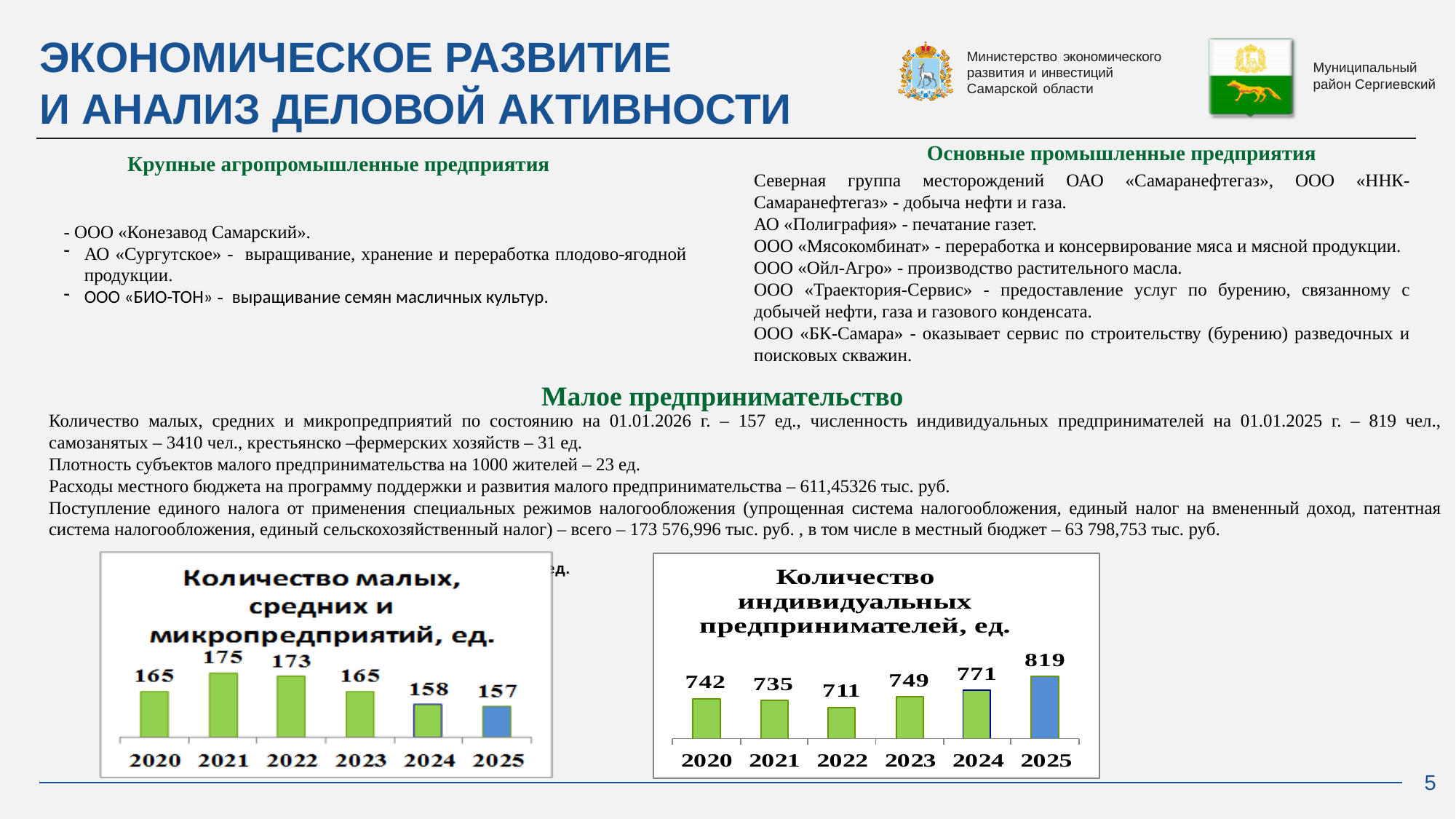
На диаграмме «Количество индивидуальных предпринимателей, ед.» какое значение указано для 2025 года? 819 На диаграмме «Количество малых, средних и микропредприятий, ед.» какое значение указано для 2021 года? 175 На диаграмме «Количество малых, средних и микропредприятий, ед.» какое значение указано для 2025 года? 157 На диаграмме «Количество индивидуальных предпринимателей, ед.» какое значение указано для 2022 года? 711 На диаграмме «Количество малых, средних и микропредприятий, ед.» на сколько значение 2021 года больше значения 2025 года? 18 Какого типа диаграмма «Количество индивидуальных предпринимателей, ед.»? Столбчатая (bar chart) На диаграмме «Количество малых, средних и микропредприятий, ед.» сколько лет (категорий) показано? 6 На диаграмме «Количество индивидуальных предпринимателей, ед.» на сколько значение 2025 года больше значения 2024 года? 48 На диаграмме «Количество индивидуальных предпринимателей, ед.» в каком году значение наибольшее? 2025 На диаграмме «Количество индивидуальных предпринимателей, ед.» в каком году значение наименьшее? 2022 На диаграмме «Количество малых, средних и микропредприятий, ед.» в каком году значение наименьшее? 2025 На диаграмме «Количество малых, средних и микропредприятий, ед.» в каком году значение наибольшее? 2021